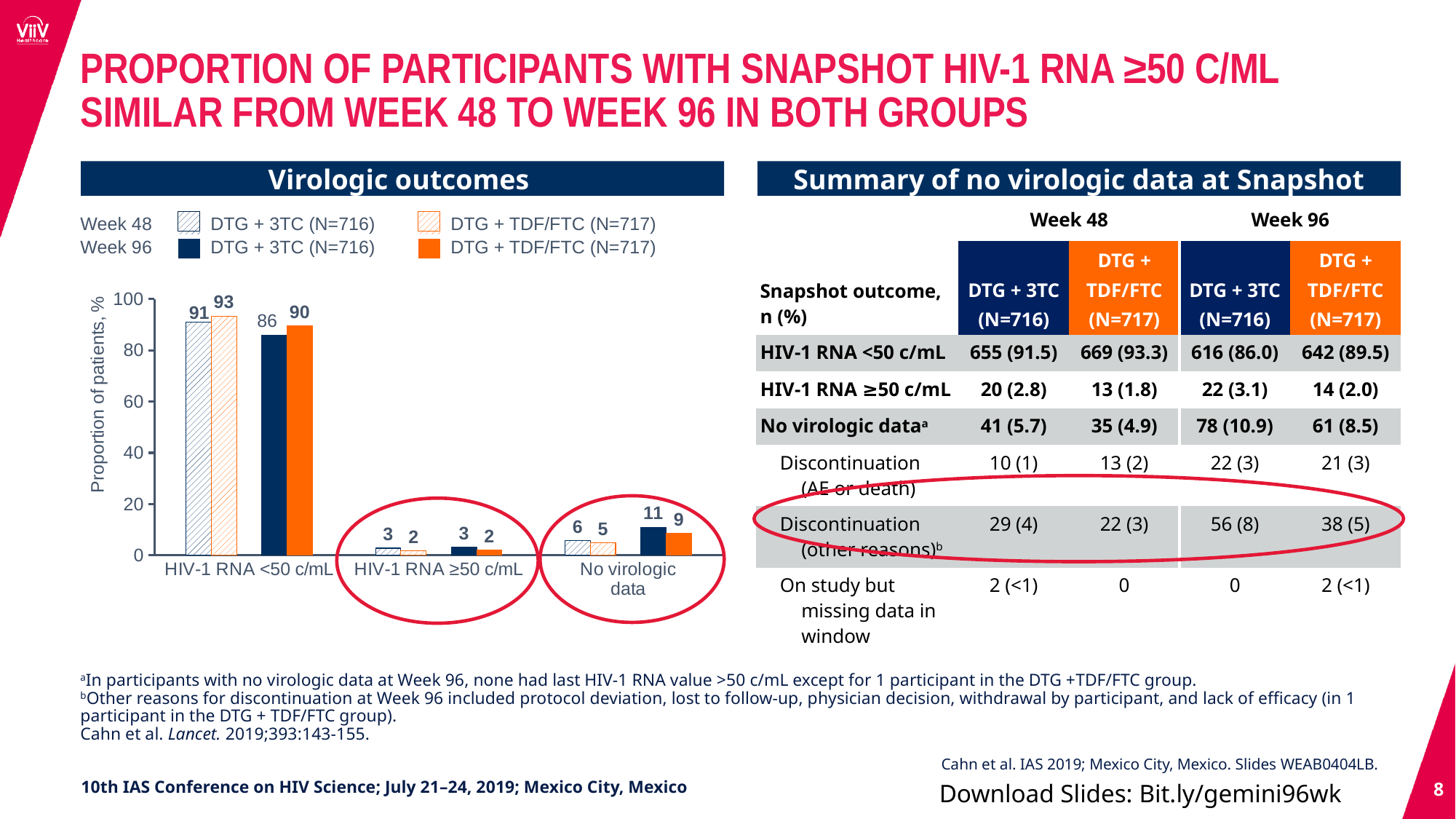
In the Virologic outcomes chart, is the Week 96 value for DTG + TDF/FTC in the HIV-1 RNA <50 c/mL category greater or less than 80? greater In the Virologic outcomes chart, what is the difference between the Week 48 and Week 96 values for DTG + 3TC in the HIV-1 RNA <50 c/mL category? 5 What kind of chart is the Virologic outcomes chart? Bar chart In the Virologic outcomes chart, what is the Week 96 value for DTG + 3TC in the HIV-1 RNA <50 c/mL category? 86 In the Virologic outcomes chart, what is the Week 48 value for DTG + 3TC in the HIV-1 RNA ≥50 c/mL category? 3 How many series does the legend of the Virologic outcomes chart list? 4 In the Virologic outcomes chart, which category has the highest values? HIV-1 RNA <50 c/mL How many categories are shown on the x axis of the Virologic outcomes chart? 3 In the Virologic outcomes chart, what is the difference between the Week 96 values for DTG + 3TC and DTG + TDF/FTC in the No virologic data category? 2 In the Virologic outcomes chart, what is the Week 96 value for DTG + 3TC in the No virologic data category? 11 In the Virologic outcomes chart, which is larger in the No virologic data category at Week 96: DTG + 3TC or DTG + TDF/FTC? DTG + 3TC In the Virologic outcomes chart, what is the Week 48 value for DTG + TDF/FTC in the HIV-1 RNA <50 c/mL category? 93